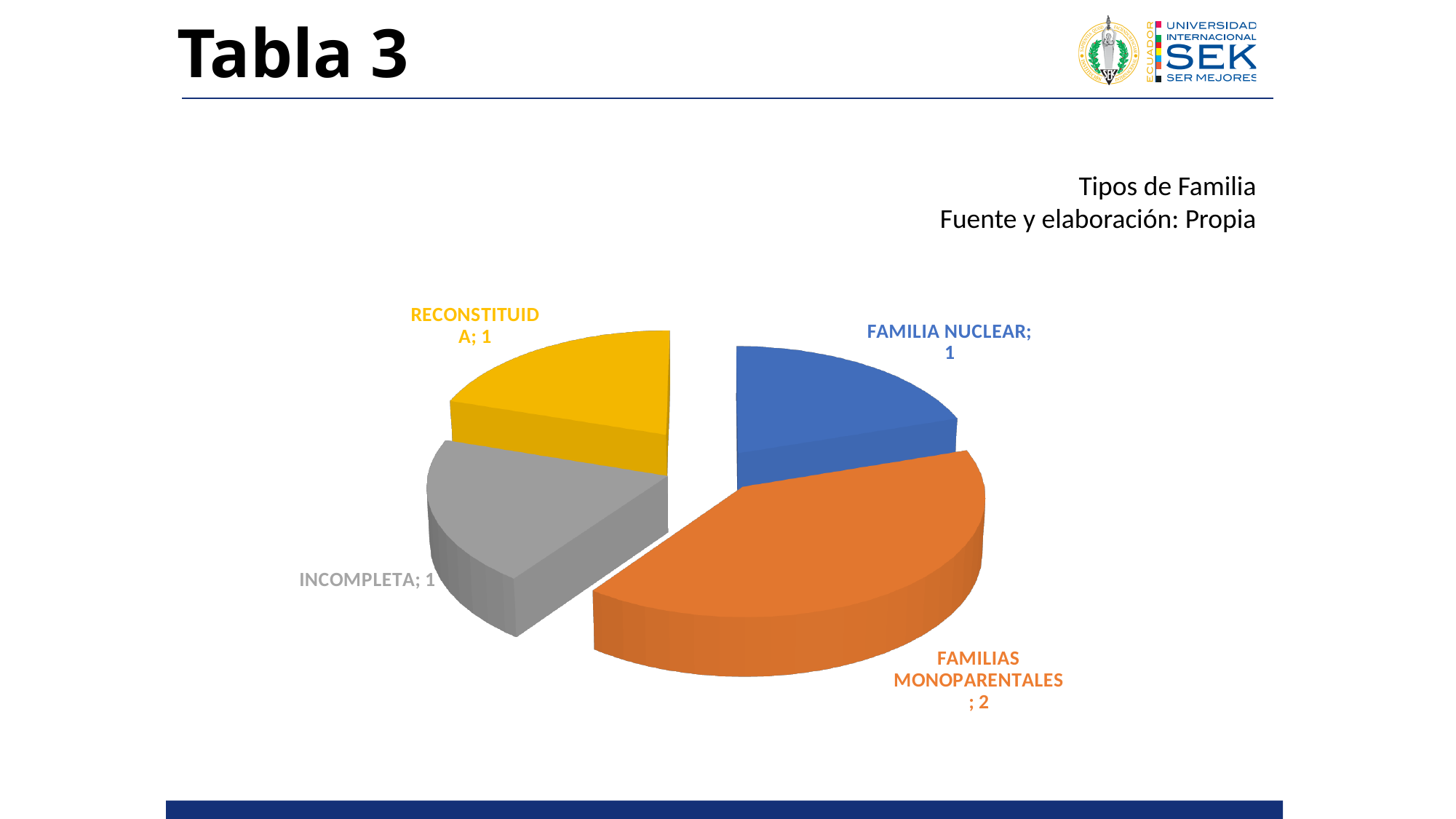
What share of the pie does RECONSTITUIDA represent? 20% What is the difference between the values for FAMILIAS MONOPARENTALES and INCOMPLETA? 1 Which category has the largest slice of the pie? FAMILIAS MONOPARENTALES Which is larger, the value for FAMILIAS MONOPARENTALES or the value for FAMILIA NUCLEAR? FAMILIAS MONOPARENTALES What is the value for RECONSTITUIDA? 1 What is the value for FAMILIA NUCLEAR? 1 What kind of chart is shown on the slide? Pie chart How many slices does the pie chart have? 4 What is the value for FAMILIAS MONOPARENTALES? 2 What share of the pie does FAMILIAS MONOPARENTALES represent? 40% What is the value for INCOMPLETA? 1 What colour is the FAMILIAS MONOPARENTALES slice? Orange